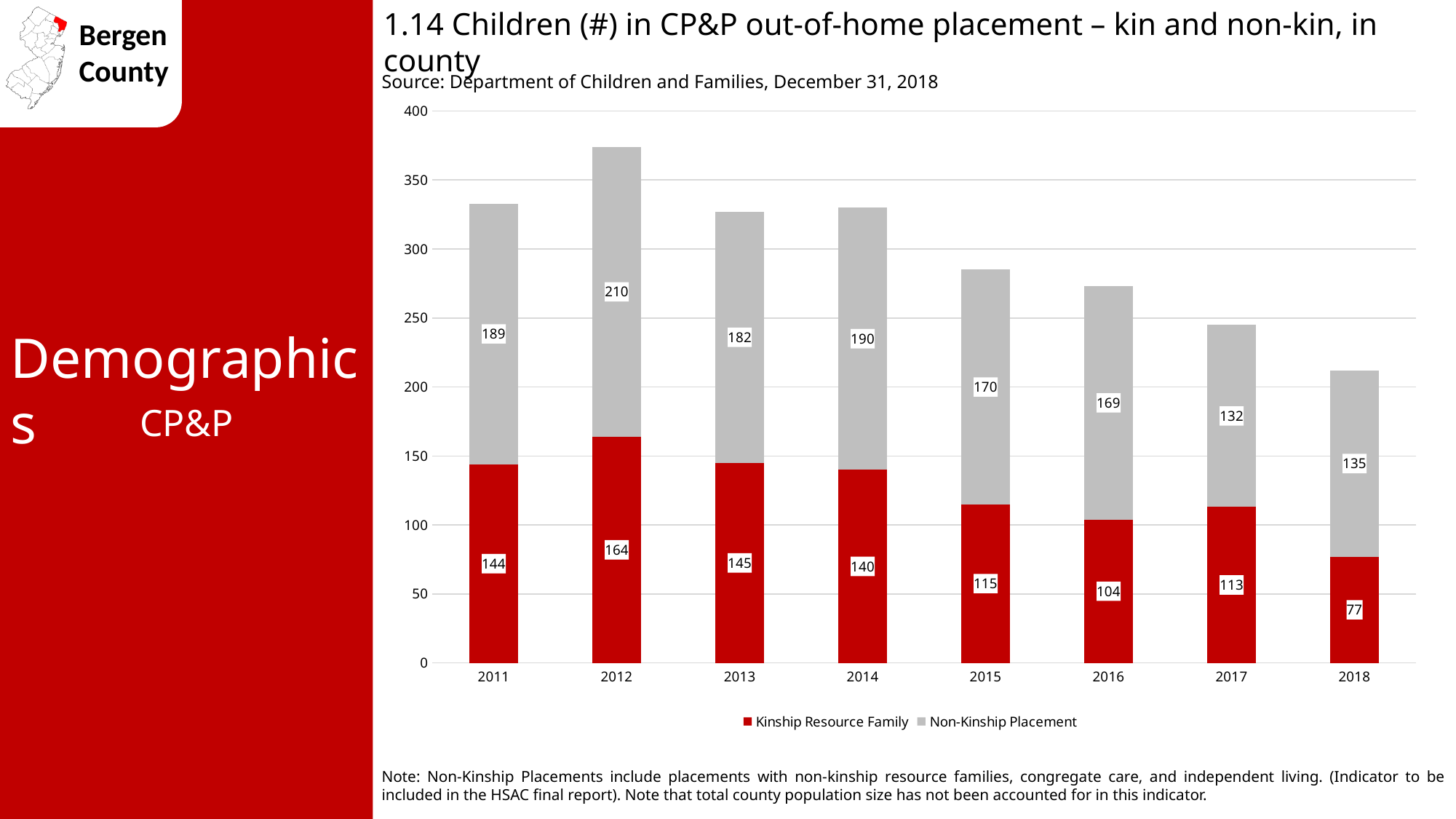
Which series is shown in red? Kinship Resource Family How many years are shown on the x axis? 8 Which year has the highest Non-Kinship Placement value? 2012 Is the total stacked bar for 2012 greater or less than 350? greater Which year has the lowest Kinship Resource Family value? 2018 What is the total of the stacked bar for 2018? 212 What kind of chart is shown on the slide? Stacked bar chart How many series does the legend list? 2 What is the Kinship Resource Family value for 2012? 164 Which is larger, the Kinship Resource Family value for 2015 or for 2017? 2015 What is the Non-Kinship Placement value for 2018? 135 What is the difference between the Non-Kinship Placement values for 2012 and 2017? 78